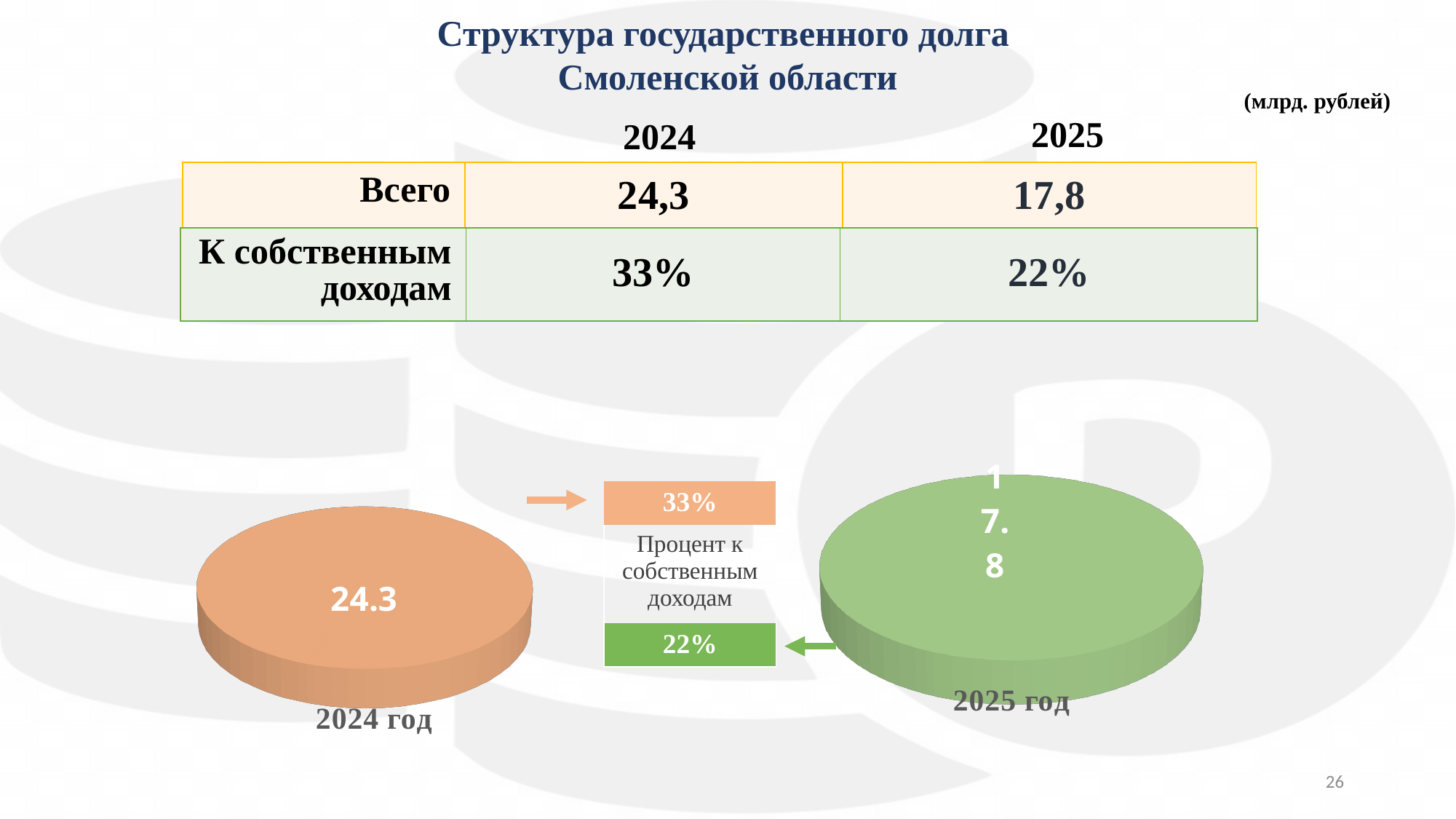
What colour is the 2024 год pie chart? orange What kind of chart is used for the 2024 год and 2025 год figures at the bottom of the slide? pie chart In the 2025 год pie chart, what value is printed on the pie? 17.8 How many pie charts are shown on the slide? 2 What is the difference between the value in the 2024 год pie chart and the value in the 2025 год pie chart? 6.5 Between the two pie charts, what percentage is shown in the green box labelled 'Процент к собственным доходам' for 2025? 22% Does the value shown in the pie charts rise or fall from 2024 год to 2025 год? fall Is the value in the 2025 год pie chart greater or less than 20? less In the 2024 год pie chart, what value is printed on the pie? 24.3 What colour is the 2025 год pie chart? green Between the two pie charts, what percentage is shown in the orange box labelled 'Процент к собственным доходам' for 2024? 33% Which pie chart shows the larger value, 2024 год or 2025 год? 2024 год